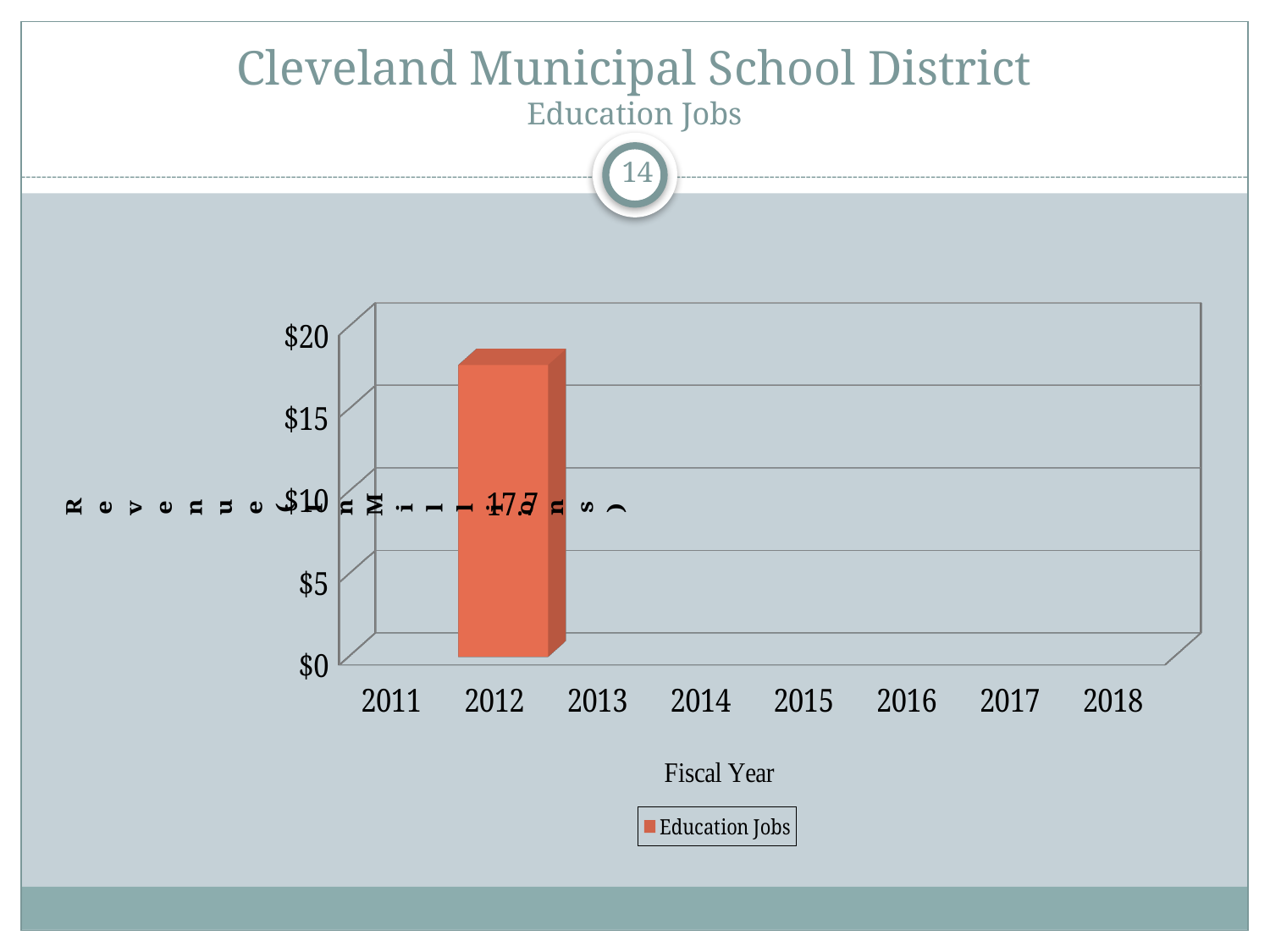
Which fiscal year is the only one with a visible bar in the chart? 2012 What is the title of the x axis of the chart? Fiscal Year How many series does the chart's legend list? 1 What is the name of the series shown in the chart's legend? Education Jobs Which fiscal year has the highest Education Jobs value in the chart? 2012 How many fiscal years are shown on the x axis of the chart? 8 Which is larger in the chart, the Education Jobs value for 2012 or for 2013? 2012 What kind of chart is shown on the slide? bar chart Is the Education Jobs value for 2012 greater or less than $15? greater Is the Education Jobs value for 2012 greater or less than $20? less